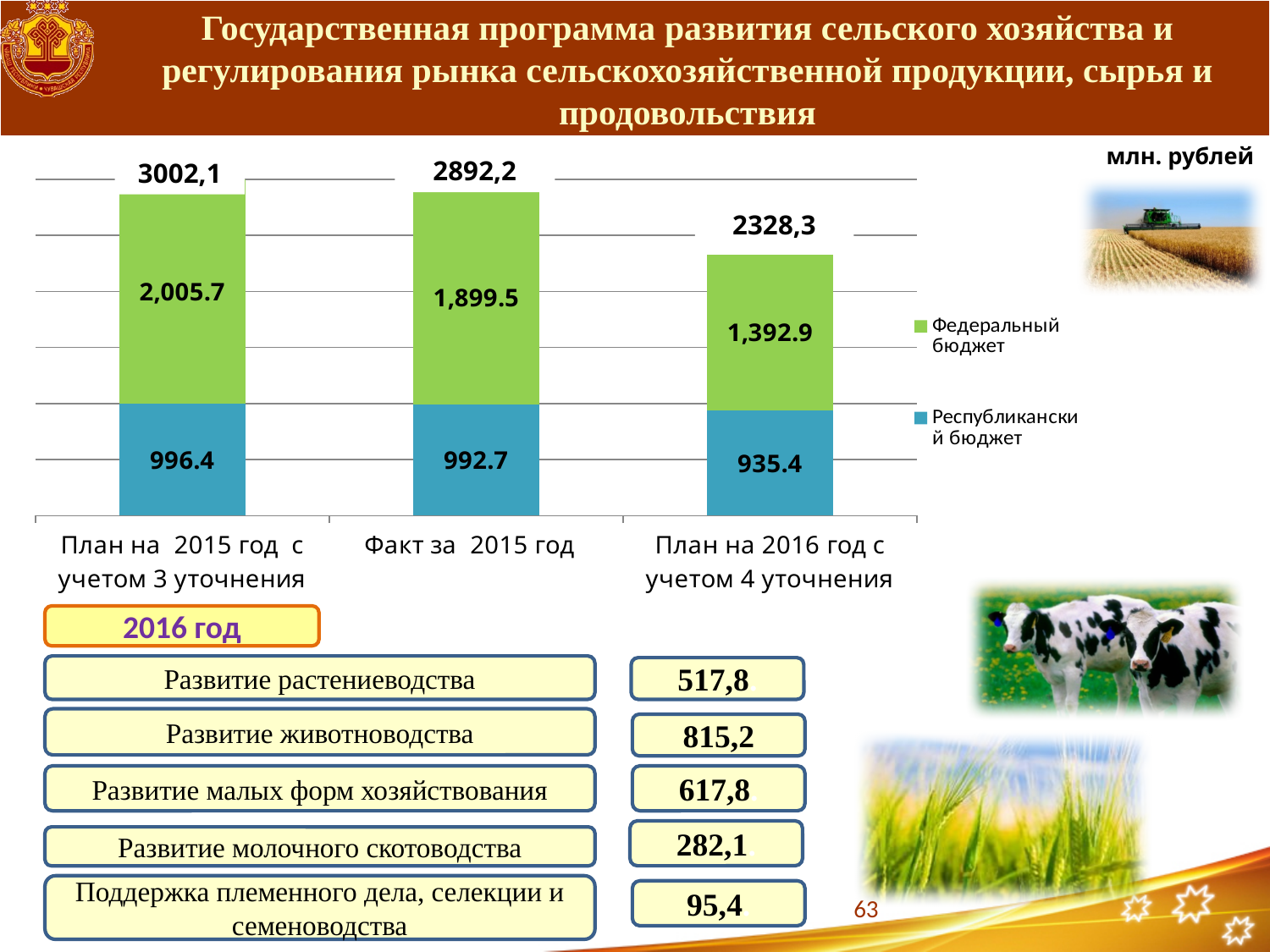
Which category has the lowest Федеральный бюджет value? План на 2016 год с учетом 4 уточнения What is the value of the Республиканский бюджет series for План на 2015 год с учетом 3 уточнения? 996.4 What is the total of the stacked bar for План на 2016 год с учетом 4 уточнения? 2328,3 What kind of chart is shown on the slide? Stacked bar chart Which is larger: the Республиканский бюджет value for Факт за 2015 год or for План на 2016 год с учетом 4 уточнения? Факт за 2015 год How many series does the chart legend list? 2 Which category has the highest stacked total? План на 2015 год с учетом 3 уточнения How many categories are shown on the x axis of the chart? 3 What is the difference between the Федеральный бюджет values for План на 2015 год с учетом 3 уточнения and Факт за 2015 год? 106.2 What is the total of the stacked bar for План на 2015 год с учетом 3 уточнения? 3002,1 What is the value of the Федеральный бюджет series for Факт за 2015 год? 1,899.5 What is the value of the Республиканский бюджет series for План на 2016 год с учетом 4 уточнения? 935.4